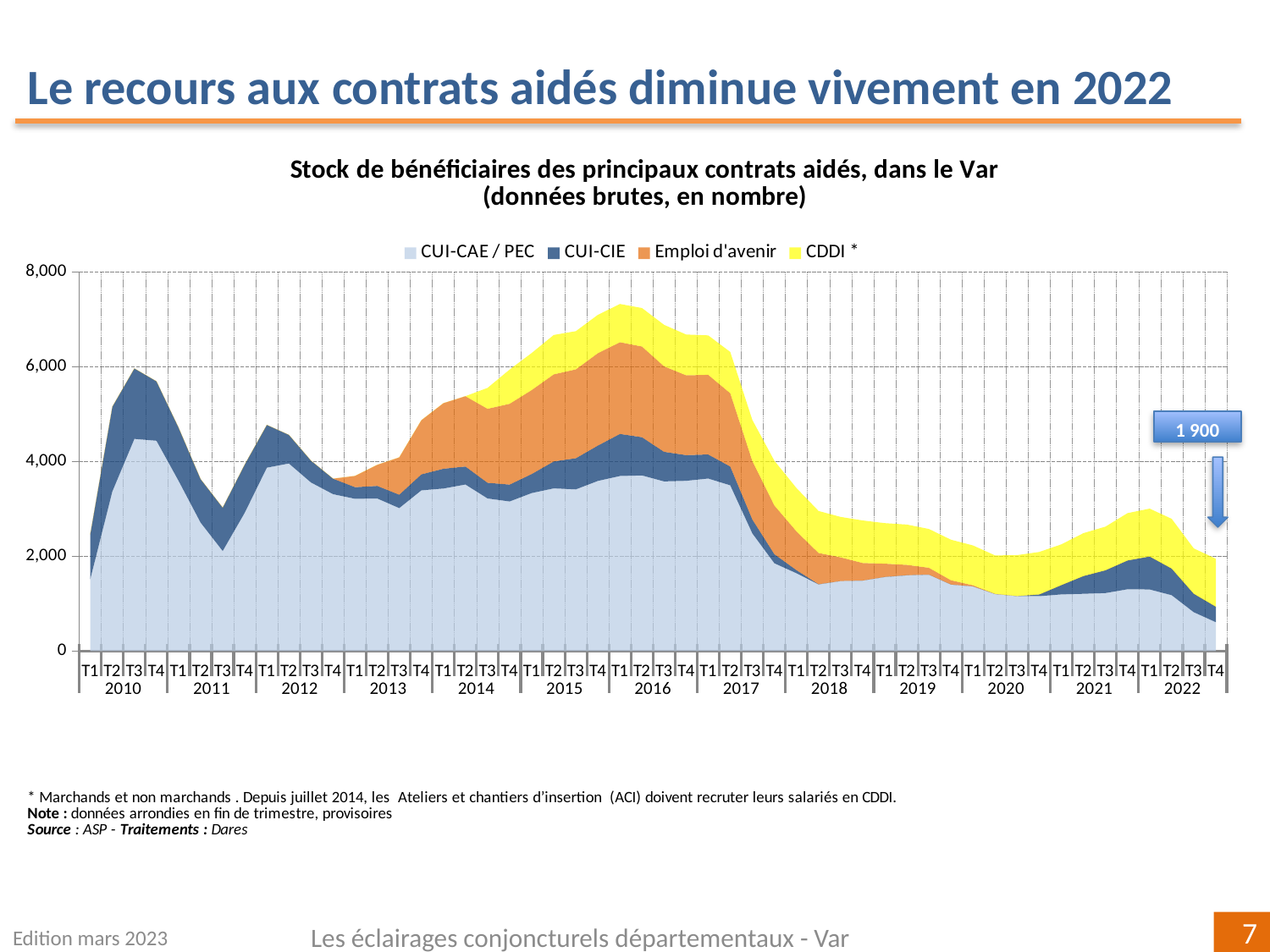
Does the total stock rise or fall between T1 2016 and T4 2022? Fall Is the total stock at T4 2022 greater or less than 2,000? less In which year does the total stock reach its highest peak? 2016 Is the total stock at T1 2016 greater or less than 6,000? greater Which series is shown in yellow in the legend? CDDI * Is the total stock at T3 2010 greater or less than 4,000? greater What is the title of the chart? Stock de bénéficiaires des principaux contrats aidés, dans le Var (données brutes, en nombre) How many series does the legend list? 4 How many years are labelled on the x axis? 13 What value is printed in the annotation at the end of the series (T4 2022)? 1 900 What kind of chart is shown on the slide? Stacked area chart